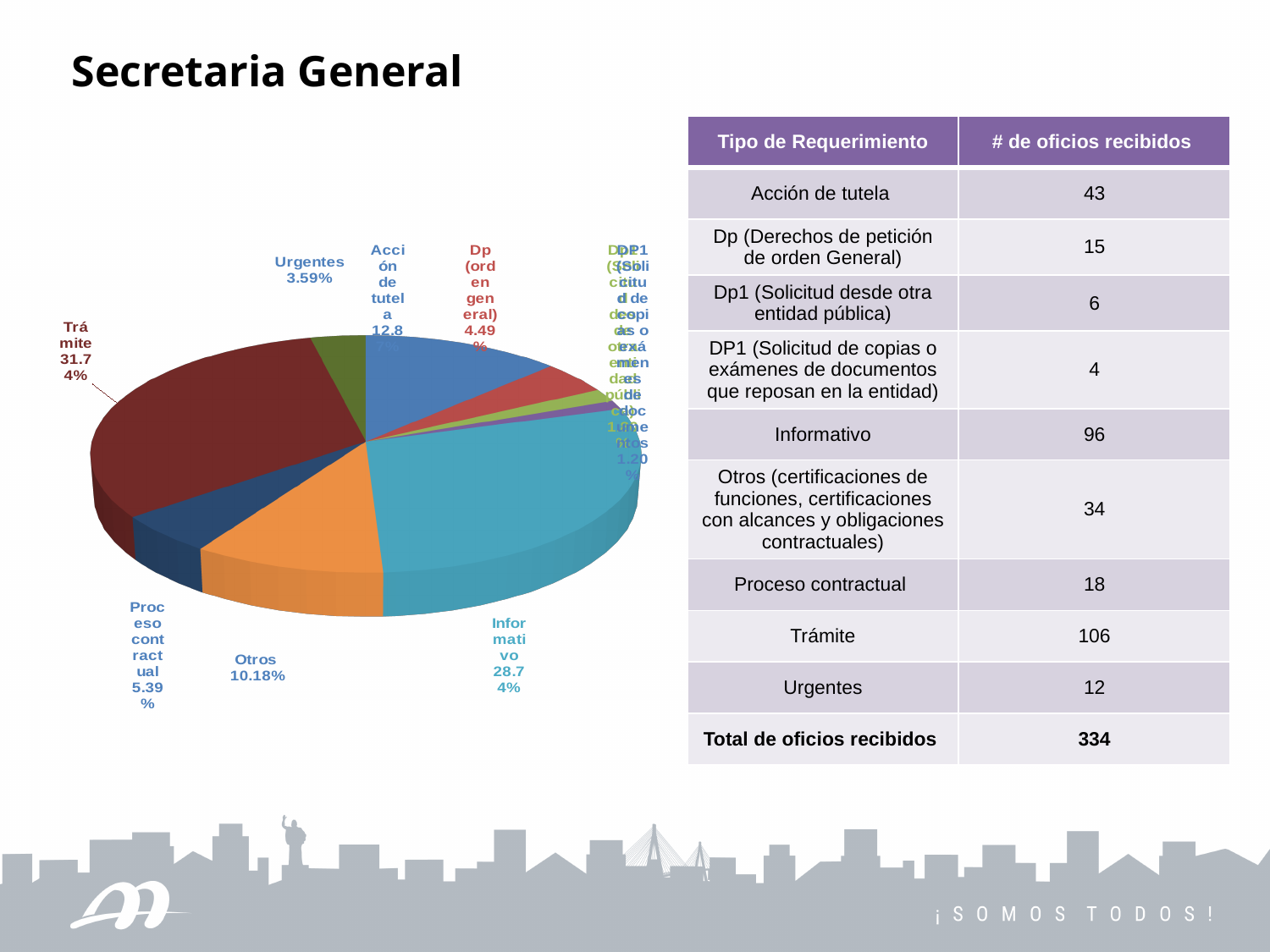
Which slice is larger in the pie chart, Otros or Proceso contractual? Otros What percentage is shown for Urgentes in the pie chart? 3.59% By how many percentage points does the Trámite slice exceed the Informativo slice? 3.00 What percentage is shown for Dp (orden general) in the pie chart? 4.49% What percentage is shown for Otros in the pie chart? 10.18% Which slice is larger in the pie chart, Trámite or Informativo? Trámite How many slices does the pie chart have? 9 What percentage is shown for Proceso contractual in the pie chart? 5.39% What share of the pie chart does Trámite represent? 31.74% Which category has the largest slice in the pie chart? Trámite What share of the pie chart does Informativo represent? 28.74% What kind of chart is shown on the slide? pie chart